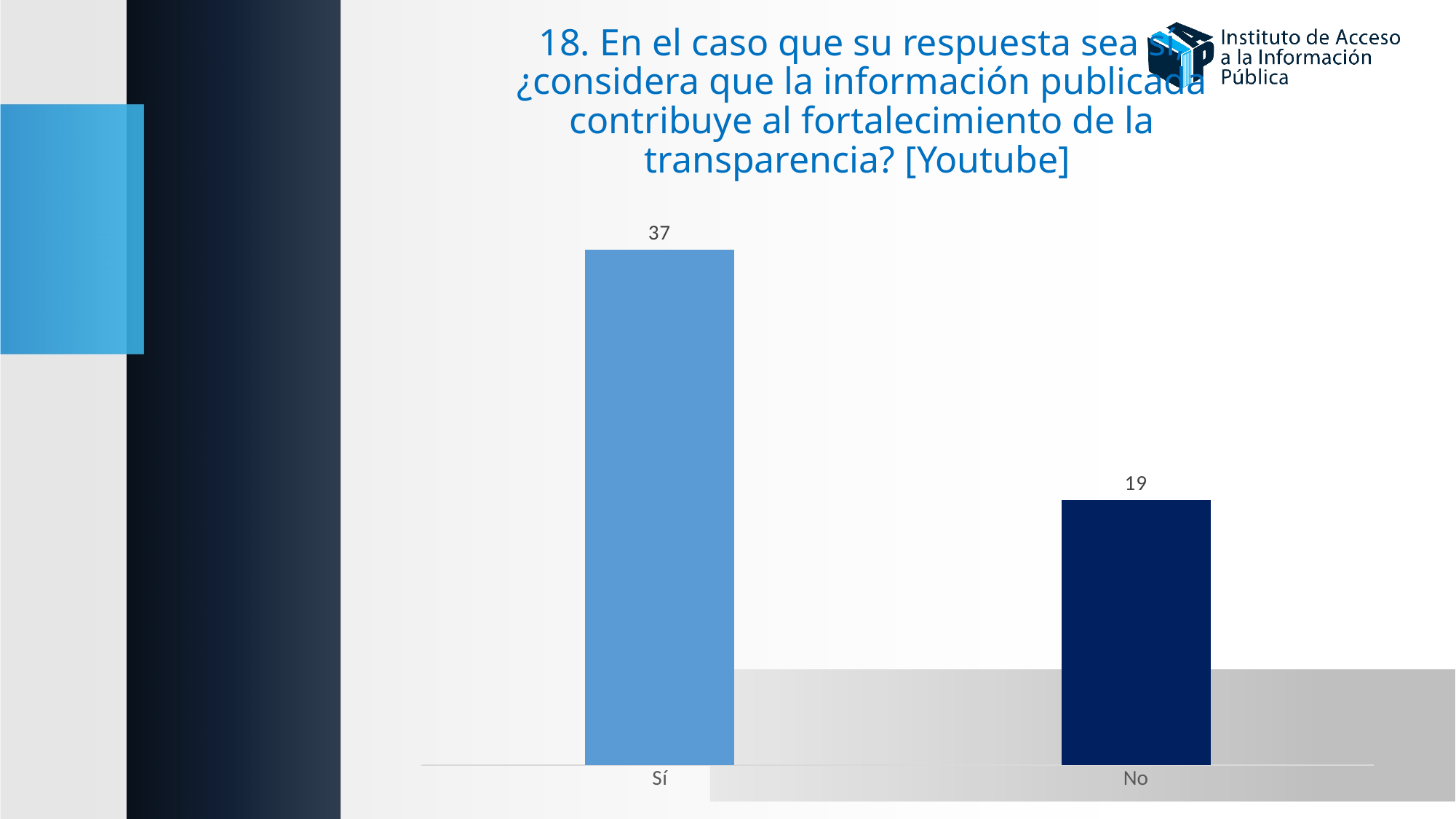
What colour is the bar for "No"? Dark navy blue Which category has the lowest value? No Which is larger, the value for "Sí" or the value for "No"? Sí What is the value for "No"? 19 Which platform is named in brackets in the chart title? Youtube What kind of chart is shown on the slide? Bar chart What is the total of the values for "Sí" and "No"? 56 Which category has the highest value? Sí What is the value for "Sí"? 37 How many categories are shown in the chart? 2 What is the difference between the values for "Sí" and "No"? 18